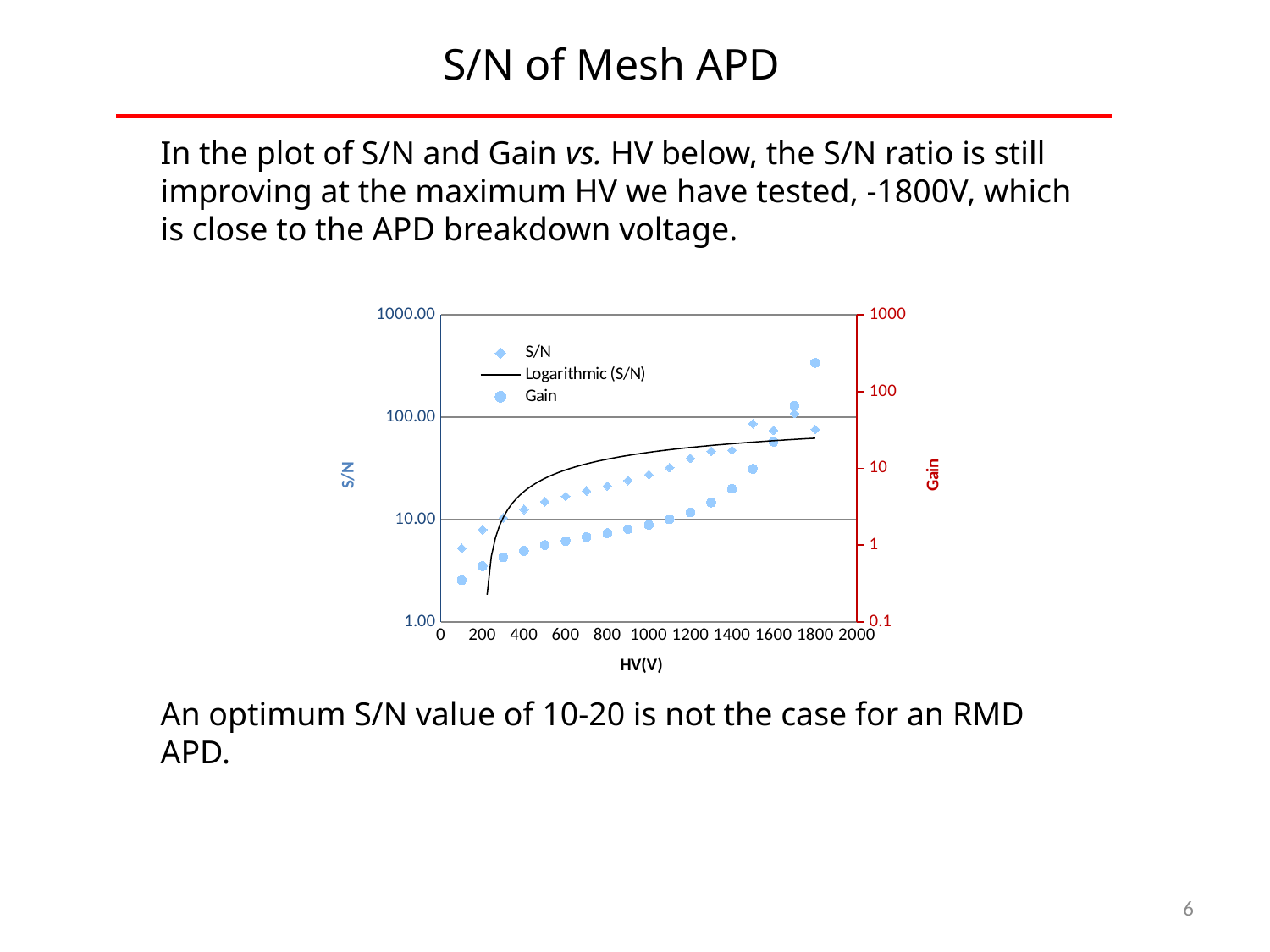
Is the Gain value at HV = 1800 greater or less than 100? greater Do the Gain values generally rise or fall as HV increases? rise What kind of chart is shown on the slide? scatter chart Which is larger, the S/N value at HV = 1800 or the S/N value at HV = 200? HV = 1800 What are the three entries in the chart legend? S/N, Logarithmic (S/N), Gain Do the S/N values generally rise or fall as HV increases? rise Is the S/N value at HV = 100 greater or less than 10? less What is the title of the x axis of the chart? HV(V) Which is larger, the Gain value at HV = 1800 or the Gain value at HV = 400? HV = 1800 How many entries does the chart legend list? 3 Is the S/N value at HV = 1800 greater or less than 100? less